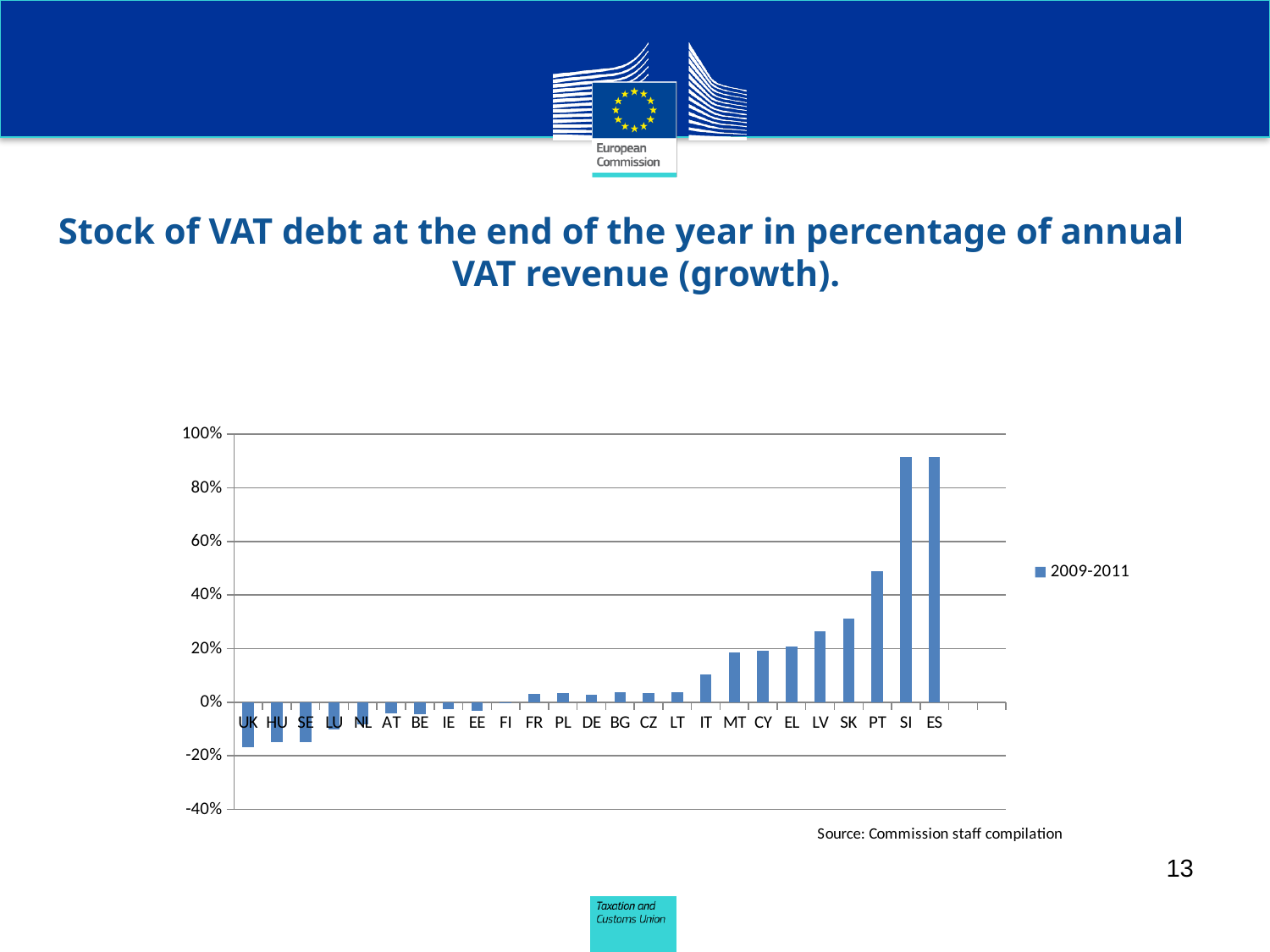
Is the value for SI greater or less than 80%? greater What source is cited below the chart? Commission staff compilation What kind of chart is shown on the slide? bar chart How many countries are plotted on the x axis? 25 Which has the larger value, IT or LV? LV Do the values generally rise or fall moving from left to right along the x axis? rise What is the name of the series shown in the legend? 2009-2011 Is the value for IT greater or less than 20%? less How many series does the legend list? 1 Which has the larger value, PT or SK? PT Is the value for UK greater or less than 0%? less